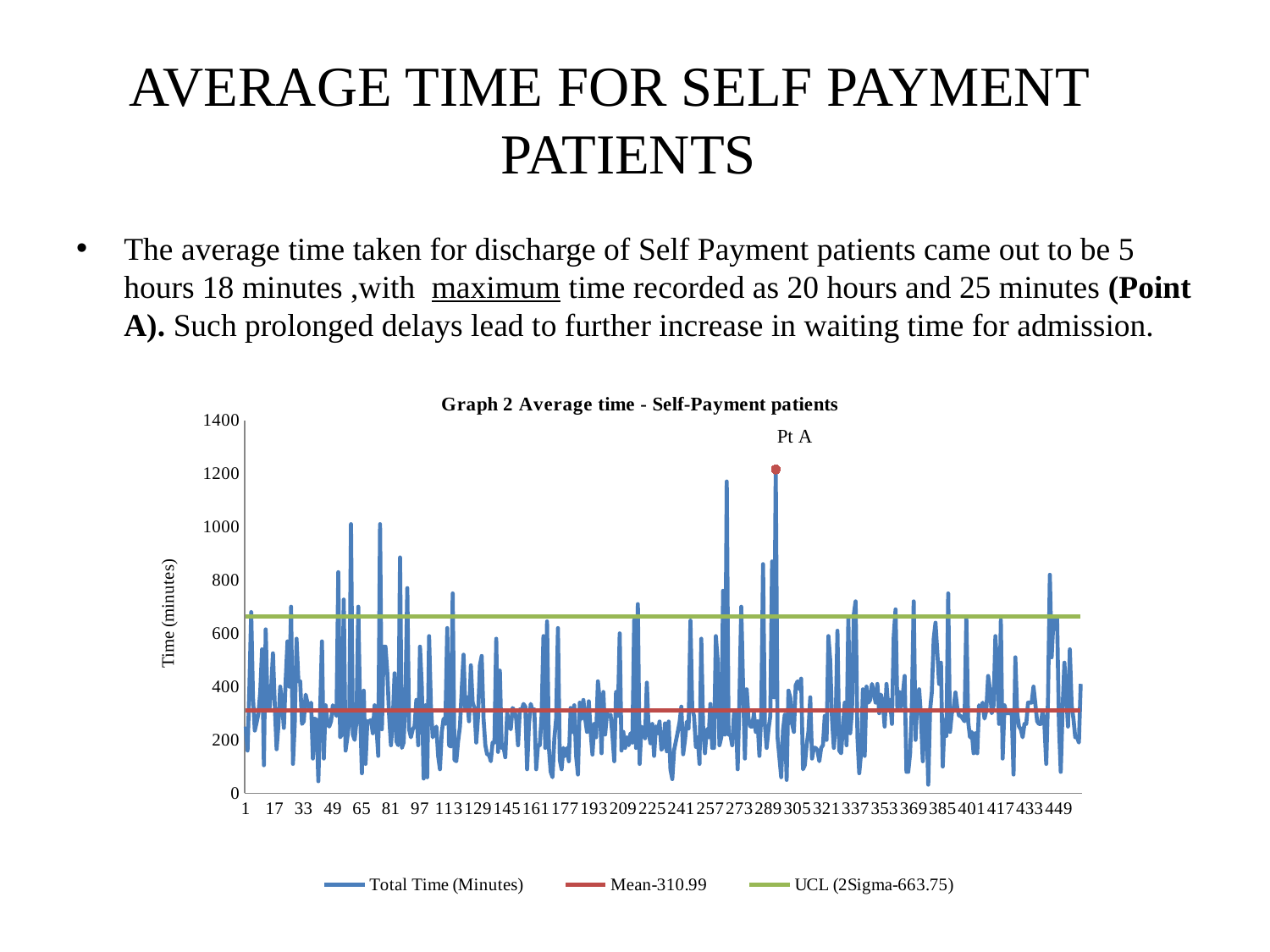
What is the label of the y axis? Time (minutes) What value is given for the Mean series in the chart legend? 310.99 How many series does the legend of the chart list? 3 What is the title of the chart? Graph 2 Average time - Self-Payment patients What is the difference between the UCL value and the Mean value shown in the legend? 352.76 Which series reaches the highest value on the chart? Total Time (Minutes) What is the highest tick value shown on the y axis? 1400 What value is given for the UCL (2Sigma) series in the chart legend? 663.75 What kind of chart is shown on the slide? line chart Is the value of the Total Time series at Pt A greater or less than 1000? greater Which is larger, the Mean line or the UCL line? UCL Is the Mean line greater or less than 400 on the y axis? less